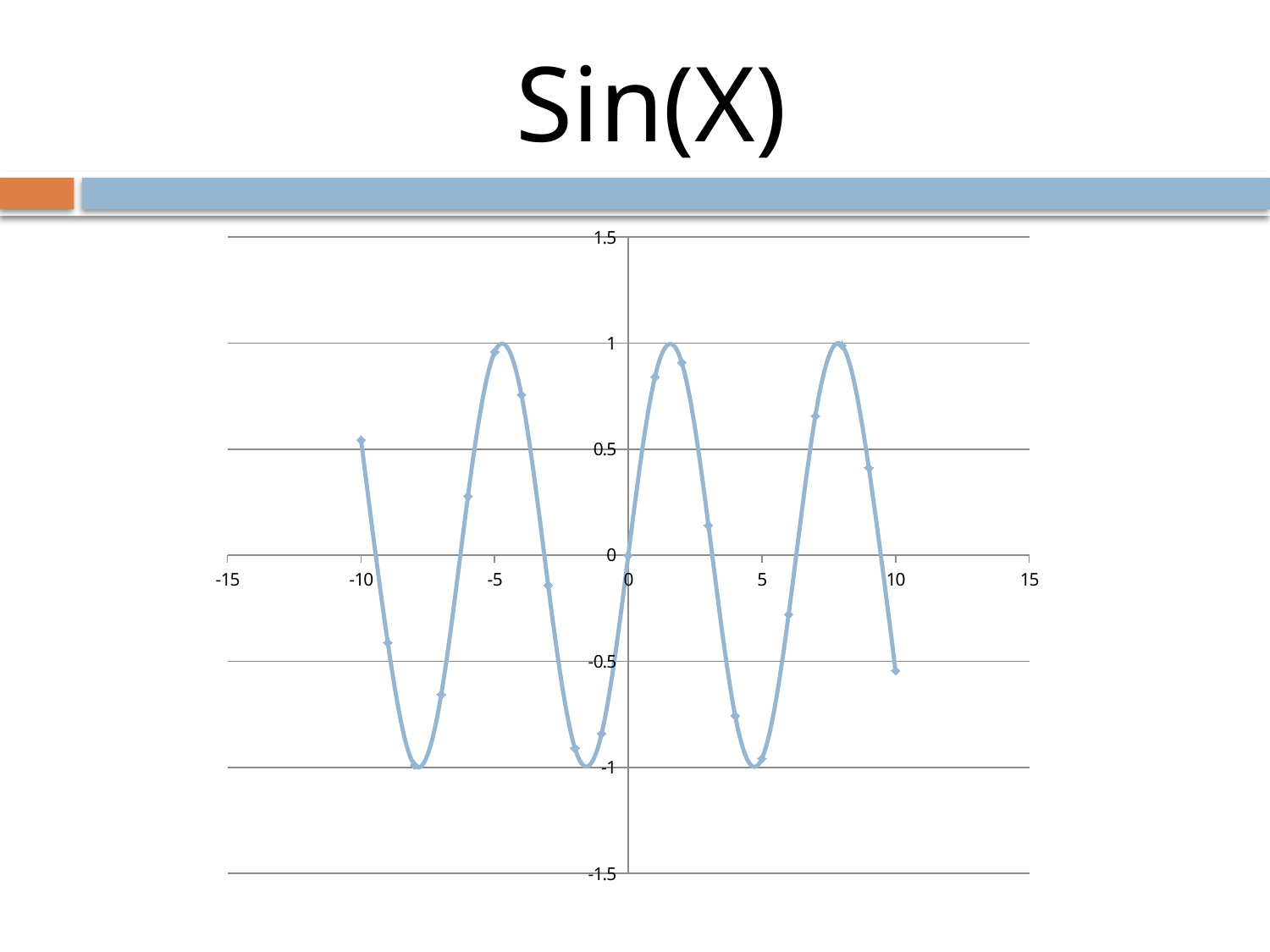
What is the plotted value at x = 0? 0 Do the plotted values rise or fall between x = 0 and x = 2? rise Which has the larger plotted value, x = -5 or x = -8? x = -5 What is the title of the chart? Sin(X) Is the plotted value at x = 7 greater or less than 0.5? greater Is the plotted value at x = -8 greater or less than -0.5? less What is the highest value shown on the y axis? 1.5 Is the plotted value at x = 5 greater or less than -0.5? less Which has the larger plotted value, x = -10 or x = 10? x = -10 How many data points are plotted on the chart? 21 What kind of chart is shown on the slide? line chart